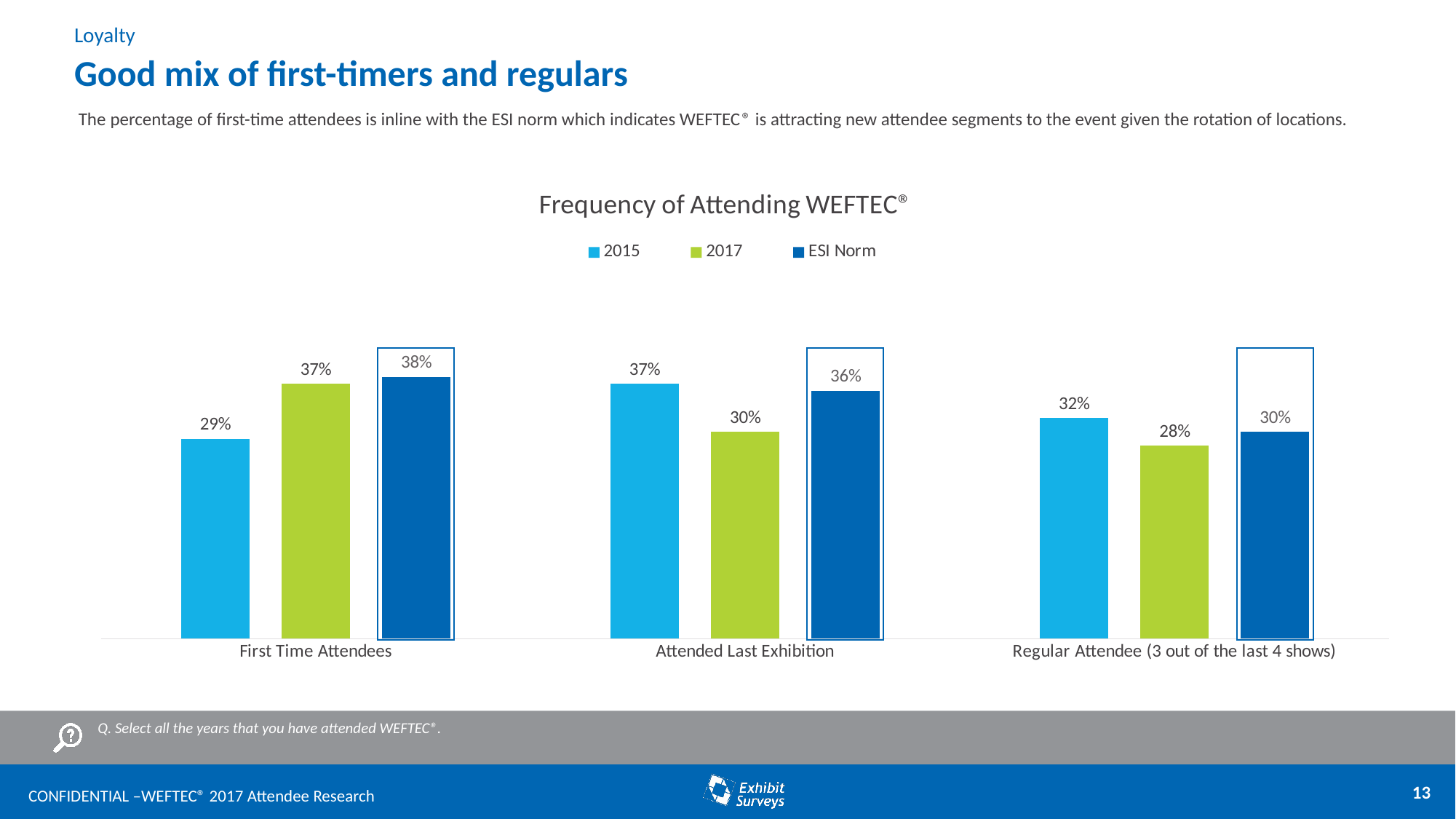
What is the 2015 value for Regular Attendee (3 out of the last 4 shows)? 32% What is the title of the chart? Frequency of Attending WEFTEC How many categories are shown on the x axis? 3 What is the difference between the 2017 and 2015 values for First Time Attendees? 8 percentage points What is the 2017 value for First Time Attendees? 37% Which category has the highest 2015 value? Attended Last Exhibition Which category has the lowest 2017 value? Regular Attendee (3 out of the last 4 shows) Which is larger for Attended Last Exhibition, the 2015 value or the 2017 value? 2015 What is the 2017 value for Regular Attendee (3 out of the last 4 shows)? 28% How many series does the legend list? 3 What is the ESI Norm value for Attended Last Exhibition? 36% What kind of chart is shown? Bar chart